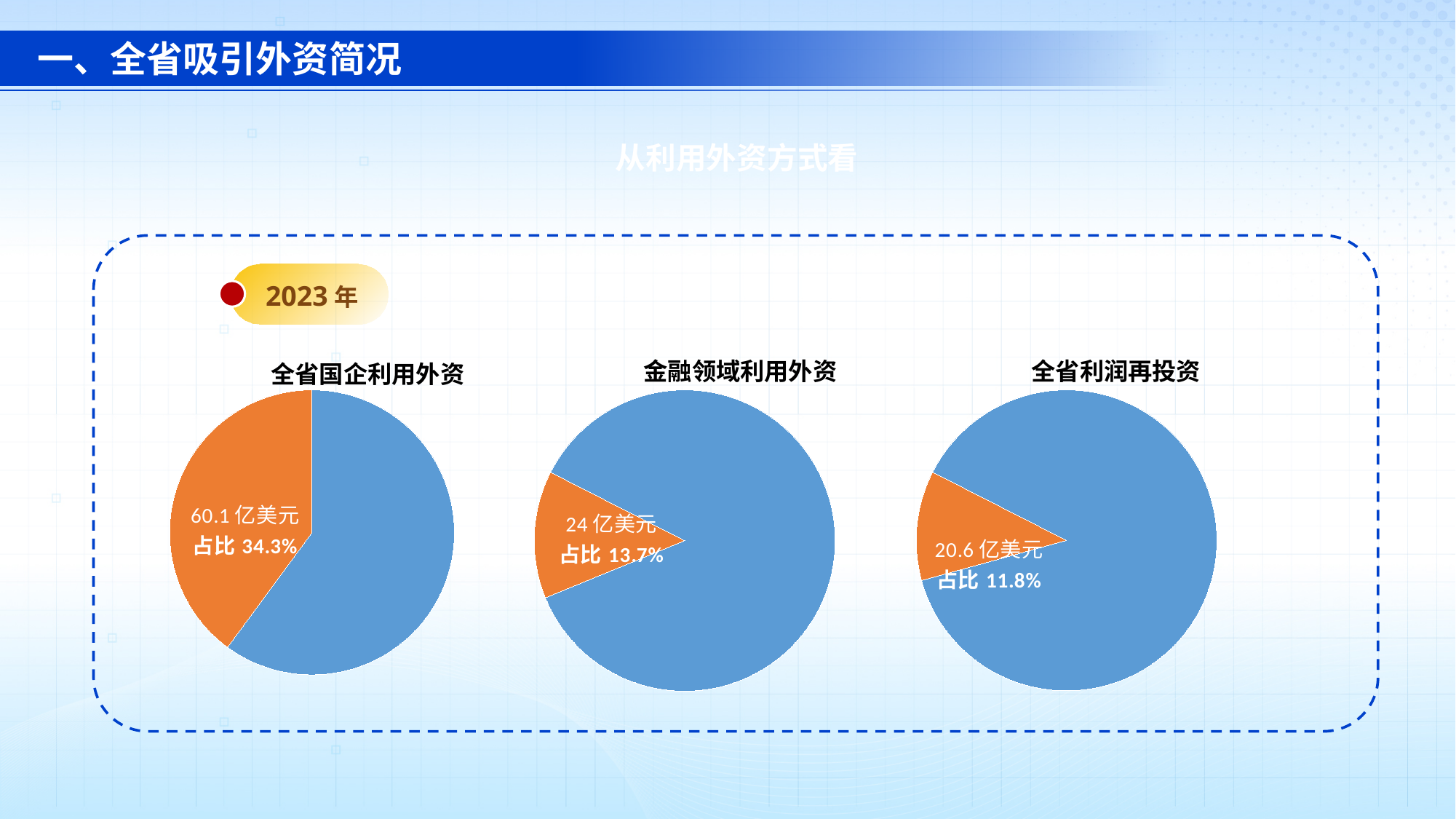
In the 全省国企利用外资 pie chart, what amount is labelled on the orange slice? 60.1 亿美元 How many pie charts are on the slide? 3 What type of charts are shown on the slide? Pie charts In the 全省利润再投资 pie chart, what amount is labelled on the orange slice? 20.6 亿美元 Which of the three pie charts has the smallest labelled share? 全省利润再投资 Which of the three pie charts has the largest labelled share? 全省国企利用外资 In the 全省国企利用外资 pie chart, what share does the orange slice represent? 34.3% What is the difference in 亿美元 between the labelled amount in the 全省国企利用外资 chart and the labelled amount in the 金融领域利用外资 chart? 36.1 亿美元 Which year do the pie charts on the slide refer to? 2023 年 In the 金融领域利用外资 pie chart, what amount is labelled on the orange slice? 24 亿美元 In the 全省利润再投资 pie chart, what share does the orange slice represent? 11.8% In the 金融领域利用外资 pie chart, what share does the orange slice represent? 13.7%